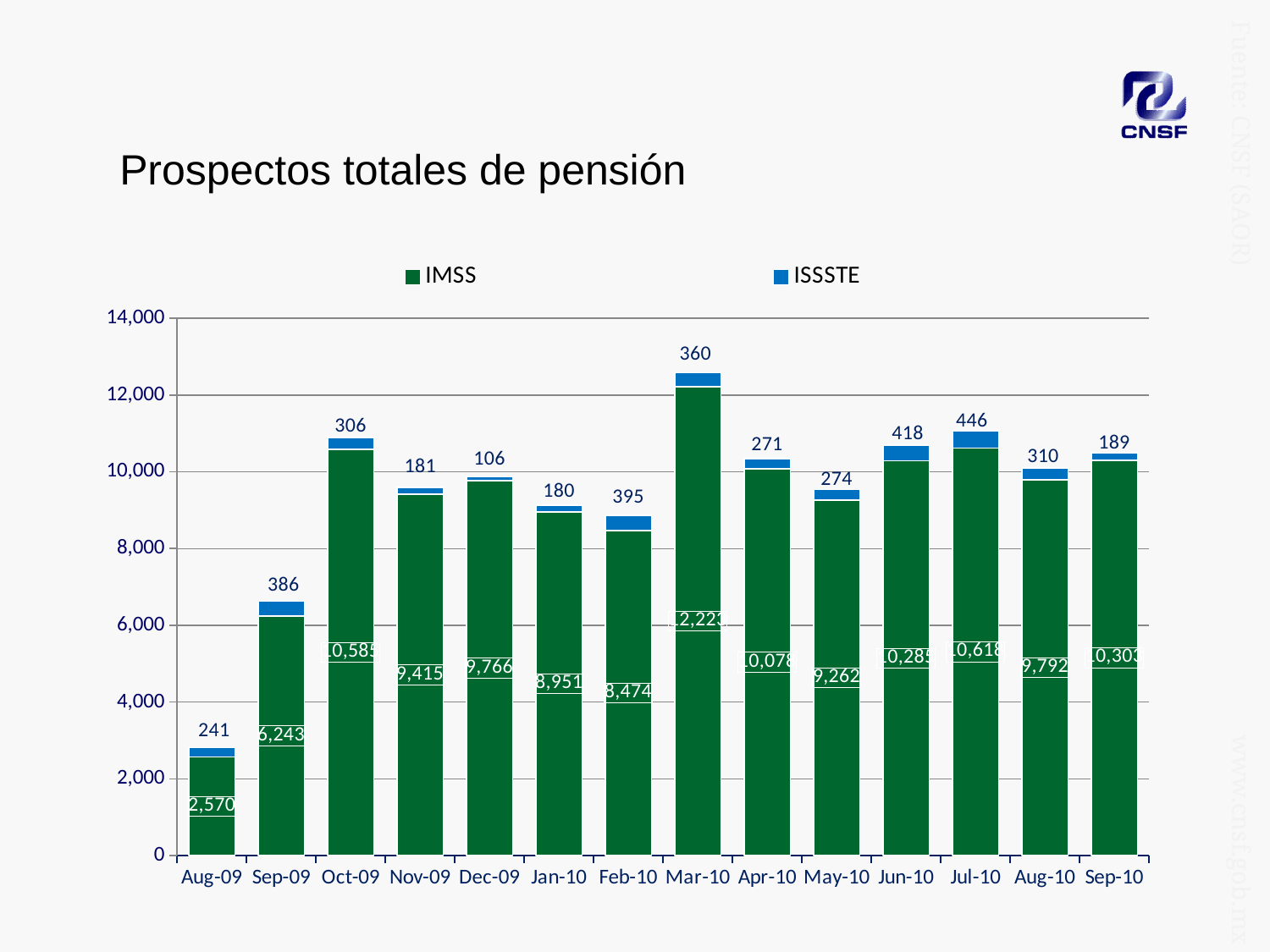
What is the total of the stacked bar for Aug-09? 2,811 What kind of chart is shown on the slide? Stacked bar chart Which is larger, the IMSS value for Dec-09 or for Jan-10? Dec-09 What is the IMSS value for Sep-09? 6,243 How many series does the legend list? 2 Which month has the highest ISSSTE value? Jul-10 What is the IMSS value for Nov-09? 9,415 What is the difference between the ISSSTE values for Jul-10 and Dec-09? 340 Which month has the highest IMSS value? Mar-10 What is the ISSSTE value for Feb-10? 395 Which month has the lowest ISSSTE value? Dec-09 How many months are shown on the x axis? 14